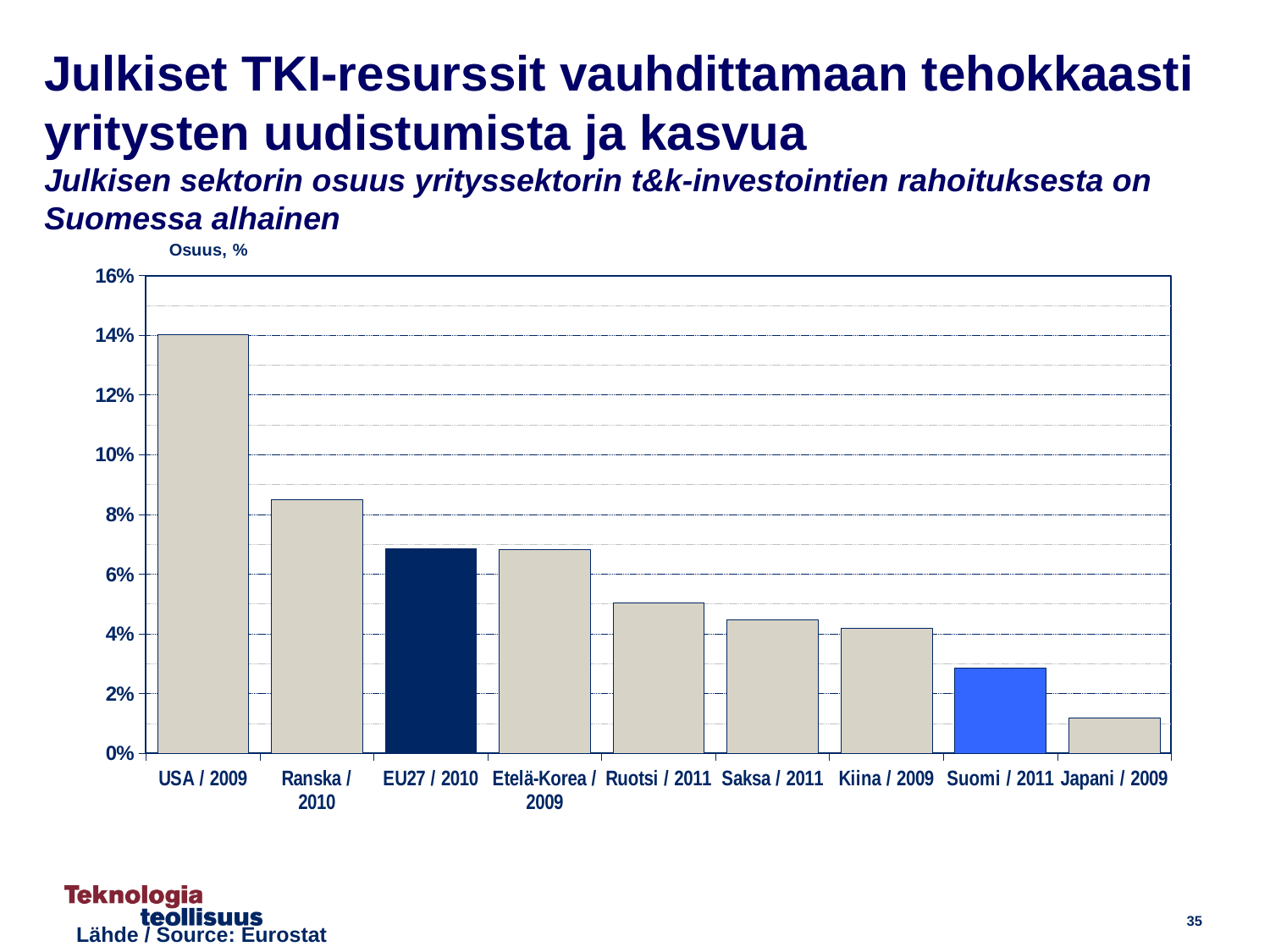
Which category has the highest value in the chart? USA / 2009 Which category has the lowest value in the chart? Japani / 2009 Is the value for Japani / 2009 greater or less than 2%? less Is the value for Suomi / 2011 greater or less than 4%? less Which is larger, the value for Kiina / 2009 or the value for Suomi / 2011? Kiina / 2009 What is the label shown above the vertical axis of the chart? Osuus, % What kind of chart is shown on the slide? bar chart How many countries/regions are shown on the x axis of the chart? 9 Is the value for Ranska / 2010 greater or less than 8%? greater Which is larger, the value for Ranska / 2010 or the value for Ruotsi / 2011? Ranska / 2010 Do the bar values rise or fall from left to right along the x axis? fall